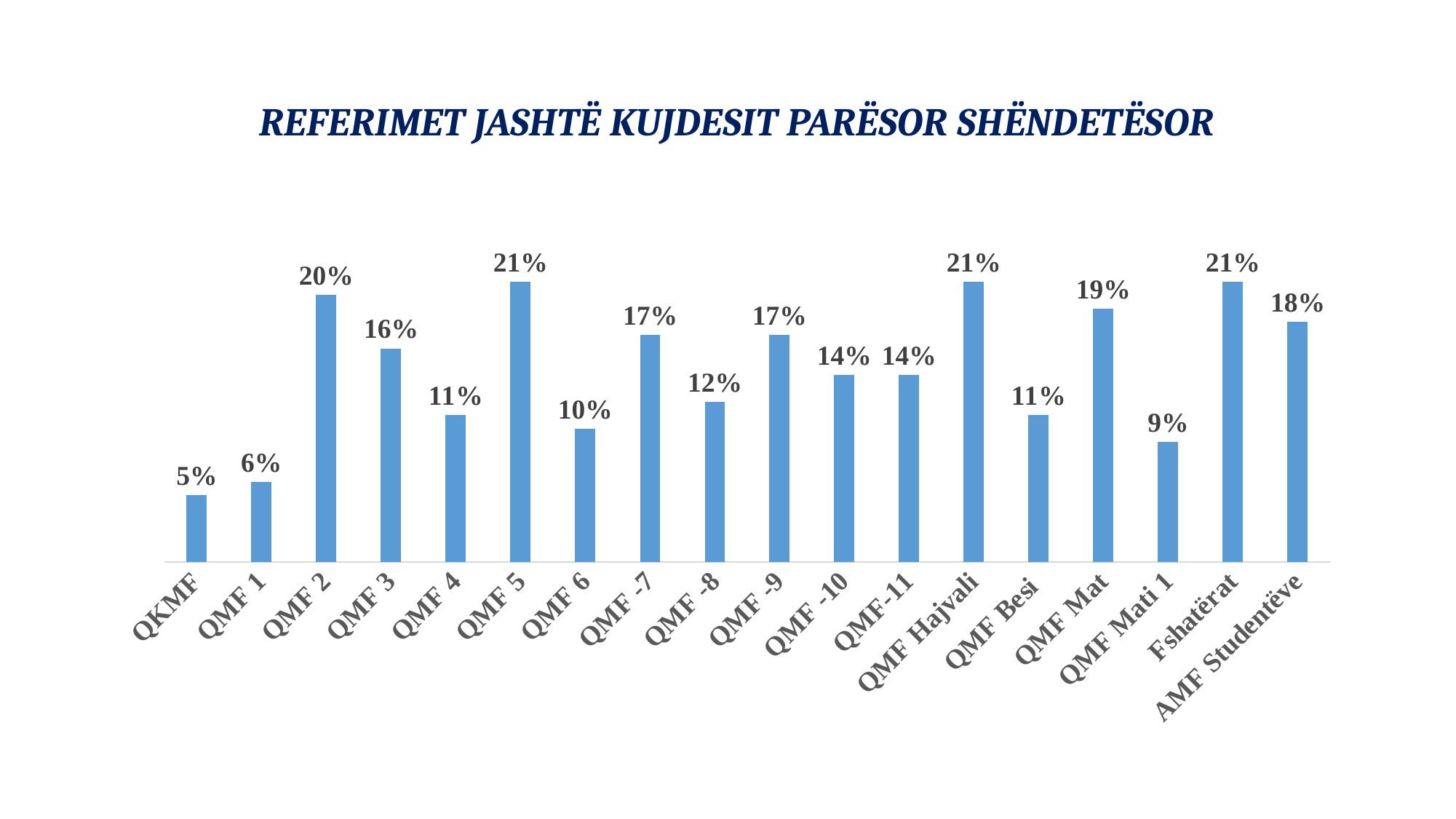
What is the highest value shown on the chart? 21% What is the value for QMF Mat? 19% What is the value for AMF Studentëve? 18% What is the title of the chart? REFERIMET JASHTË KUJDESIT PARËSOR SHËNDETËSOR What is the value for QMF Mati 1? 9% What kind of chart is shown on the slide? Bar chart How many categories are shown on the chart? 18 Which category has the lowest value? QKMF What is the difference between the values for QMF 2 and QMF 1? 14% What is the value for QMF 2? 20% What is the difference between the values for QMF Hajvali and QMF Besi? 10% Which is larger, the value for QMF 3 or the value for QMF 4? QMF 3